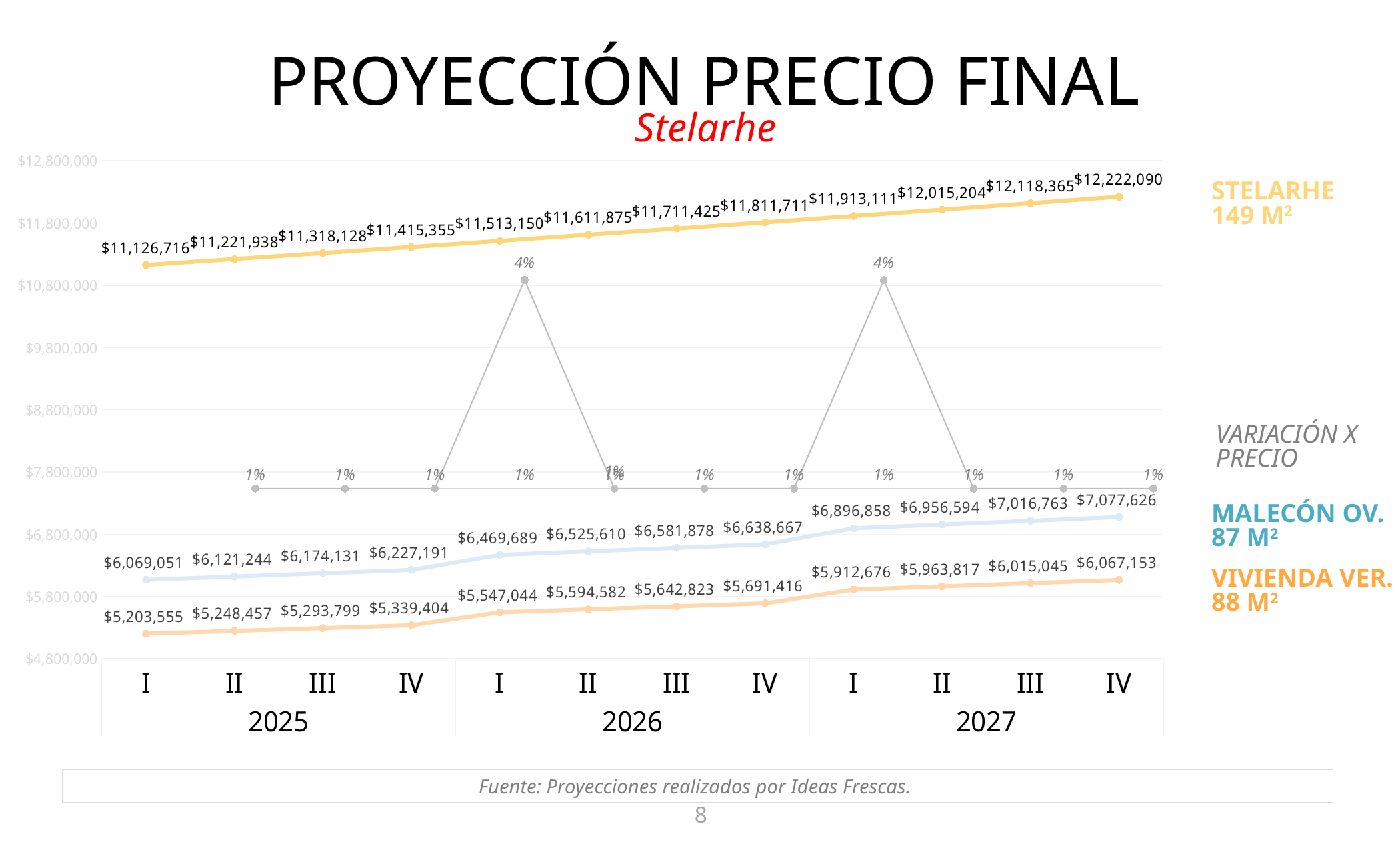
How many quarterly points are plotted along the x axis? 12 What is the difference between the Malecón Ov. 87 m² price and the Vivienda Ver. 88 m² price in quarter IV of 2027? $1,010,473 What is the Variación x precio value shown for quarter I of 2027? 4% What is the projected price for Vivienda Ver. 88 m² in quarter I of 2026? $5,547,044 By how much does the Stelarhe 149 m² price increase from quarter I of 2025 to quarter IV of 2027? $1,095,374 Which series has the lowest projected prices across the chart? Vivienda Ver. 88 m² Do the Stelarhe 149 m² prices rise or fall from 2025 to 2027? Rise Which series has the highest projected prices across the chart? Stelarhe 149 m² Which is larger: the Malecón Ov. 87 m² price in quarter IV of 2027 or the Vivienda Ver. 88 m² price in quarter IV of 2027? Malecón Ov. 87 m² What is the projected price for Stelarhe 149 m² in quarter I of 2025? $11,126,716 What is the projected price for Malecón Ov. 87 m² in quarter IV of 2027? $7,077,626 What kind of chart is shown on the slide? Line chart